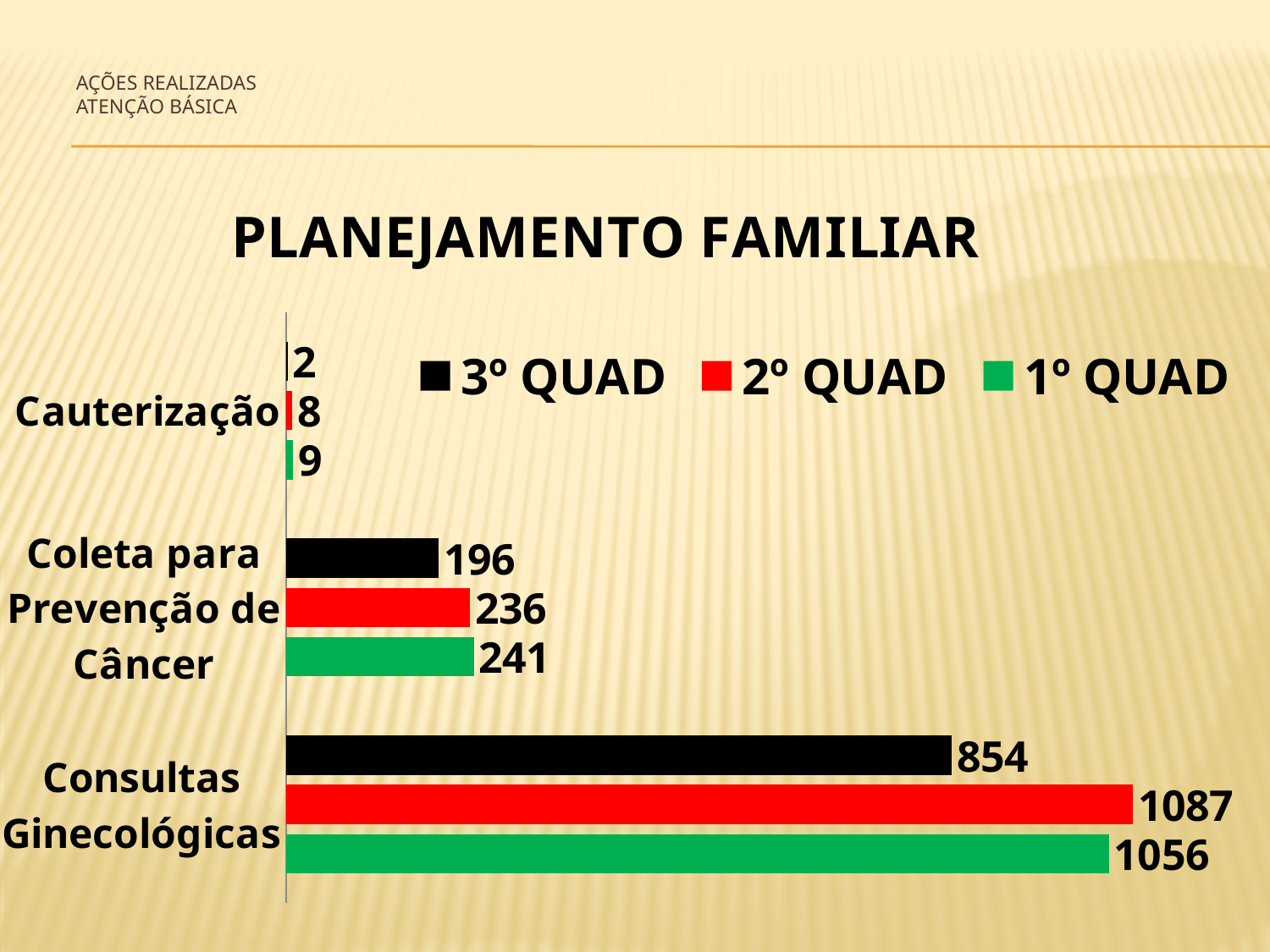
Which is larger for Consultas Ginecológicas: the 1º QUAD value or the 3º QUAD value? 1º QUAD What is the value for Coleta para Prevenção de Câncer in the 3º QUAD series? 196 What is the difference between the 2º QUAD and 3º QUAD values for Consultas Ginecológicas? 233 Which category has the lowest value in the 2º QUAD series? Cauterização What kind of chart is shown on the slide? Bar chart How many series does the legend list? 3 What is the value for Consultas Ginecológicas in the 2º QUAD series? 1087 What is the value for Consultas Ginecológicas in the 1º QUAD series? 1056 Which category has the highest value in the 3º QUAD series? Consultas Ginecológicas What is the difference between the 1º QUAD and 2º QUAD values for Coleta para Prevenção de Câncer? 5 How many categories are shown on the chart? 3 What is the value for Cauterização in the 1º QUAD series? 9